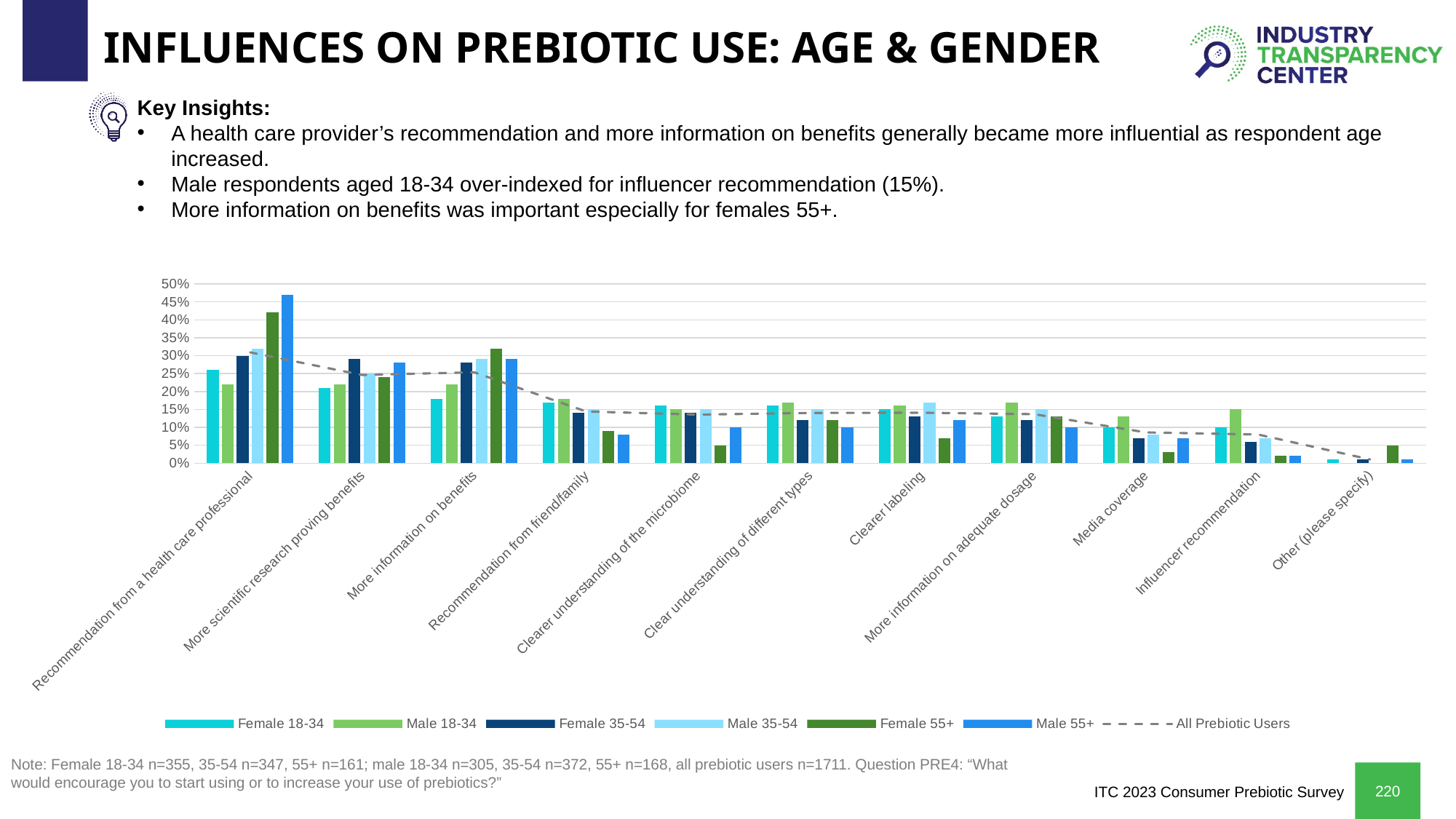
How many categories are shown along the x axis of the chart? 11 Which is larger for 'Influencer recommendation': the Male 18-34 bar or the Female 55+ bar? Male 18-34 Which category has the lowest values overall across the series? Other (please specify) Which series has the highest bar for 'Recommendation from a health care professional'? Male 55+ What kind of chart is shown on the slide? combination bar and line chart Is the value for Male 55+ under 'Recommendation from a health care professional' greater or less than 45%? greater How many series does the chart's legend list? 7 Which series is represented by the dashed grey line in the chart? All Prebiotic Users Is the value for Female 55+ under 'Clearer understanding of the microbiome' greater or less than 10%? less Does the dashed 'All Prebiotic Users' line generally rise or fall moving from left to right along the x axis? fall Which is larger for 'Recommendation from a health care professional': the Female 18-34 bar or the Male 55+ bar? Male 55+